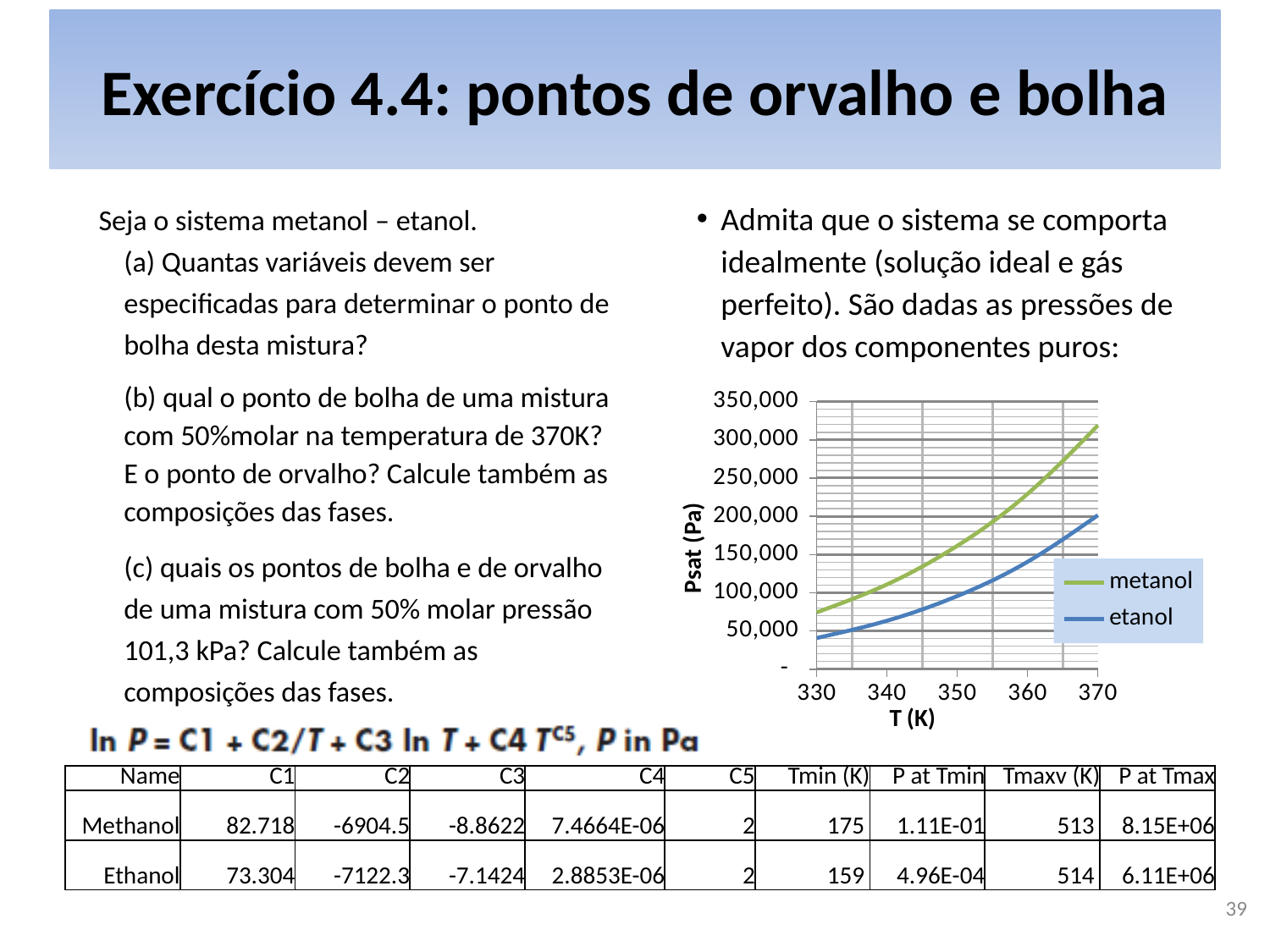
Is the Psat value for etanol at 370 K greater or less than 250,000? less At T = 330 K, which series has the lower Psat, metanol or etanol? etanol Do the Psat values for etanol rise or fall as T increases along the x axis? rise What kind of chart is shown on the slide? line chart What is the label of the chart's vertical axis? Psat (Pa) Which two series are listed in the chart legend? metanol and etanol Do the Psat values for metanol rise or fall as T increases from 330 to 370 K? rise Is the Psat value for etanol at 330 K greater or less than 50,000? less At T = 370 K, which series has the higher Psat, metanol or etanol? metanol Is the Psat value for metanol at 370 K greater or less than 300,000? greater How many series does the chart legend list? 2